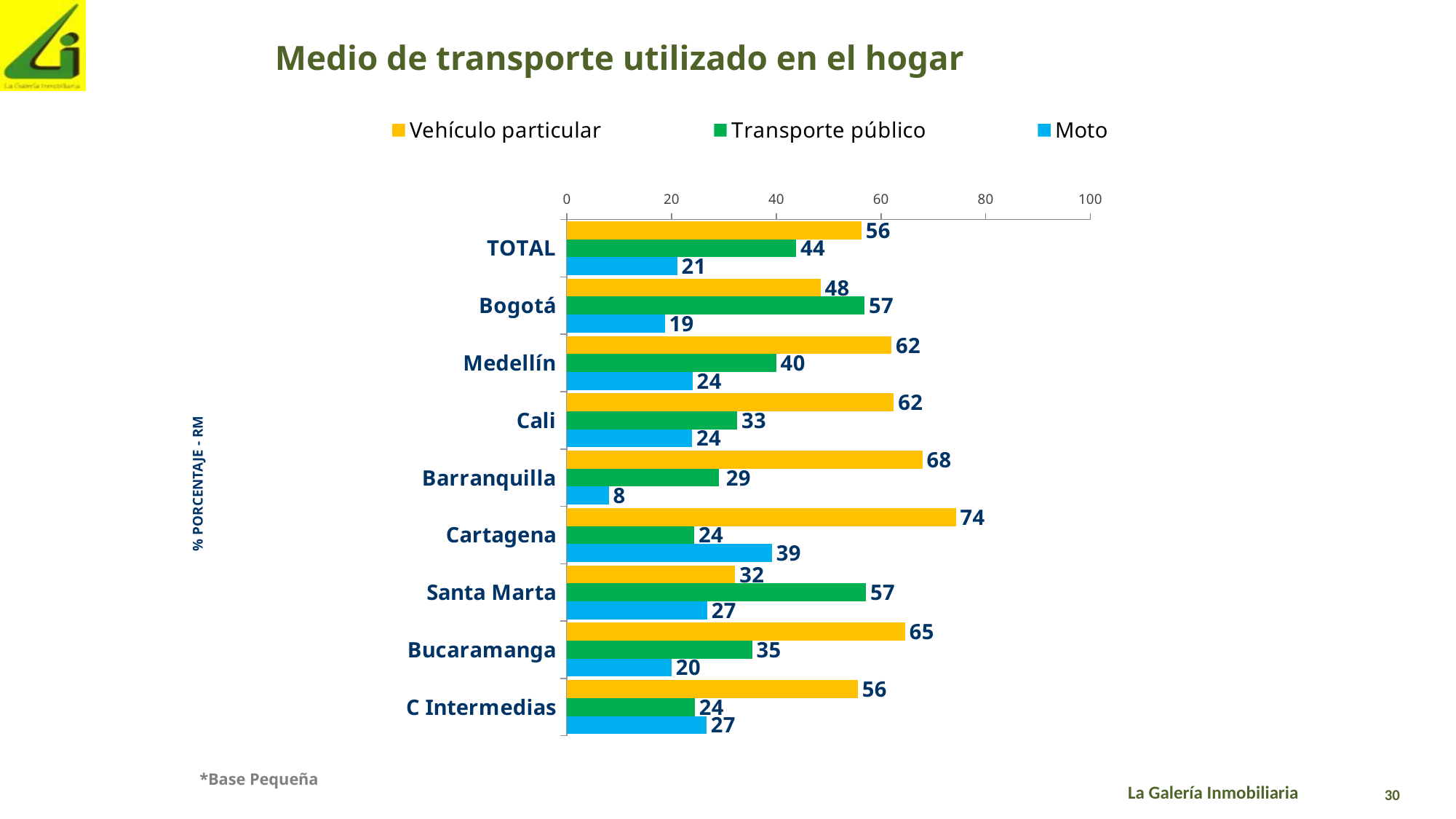
What is the difference between Transporte público and Vehículo particular in Santa Marta? 25 What is the value for Vehículo particular in Cartagena? 74 Which category has the lowest value for Moto? Barranquilla How many categories are shown on the y axis? 9 What is the value for Moto in the TOTAL category? 21 What is the title of the chart? Medio de transporte utilizado en el hogar How many series does the legend list? 3 What kind of chart is shown on the slide? Bar chart Which is larger in Bogotá, Vehículo particular or Transporte público? Transporte público Which category has the highest value for Vehículo particular? Cartagena What is the value for Transporte público in Bogotá? 57 What is the value for Moto in Barranquilla? 8